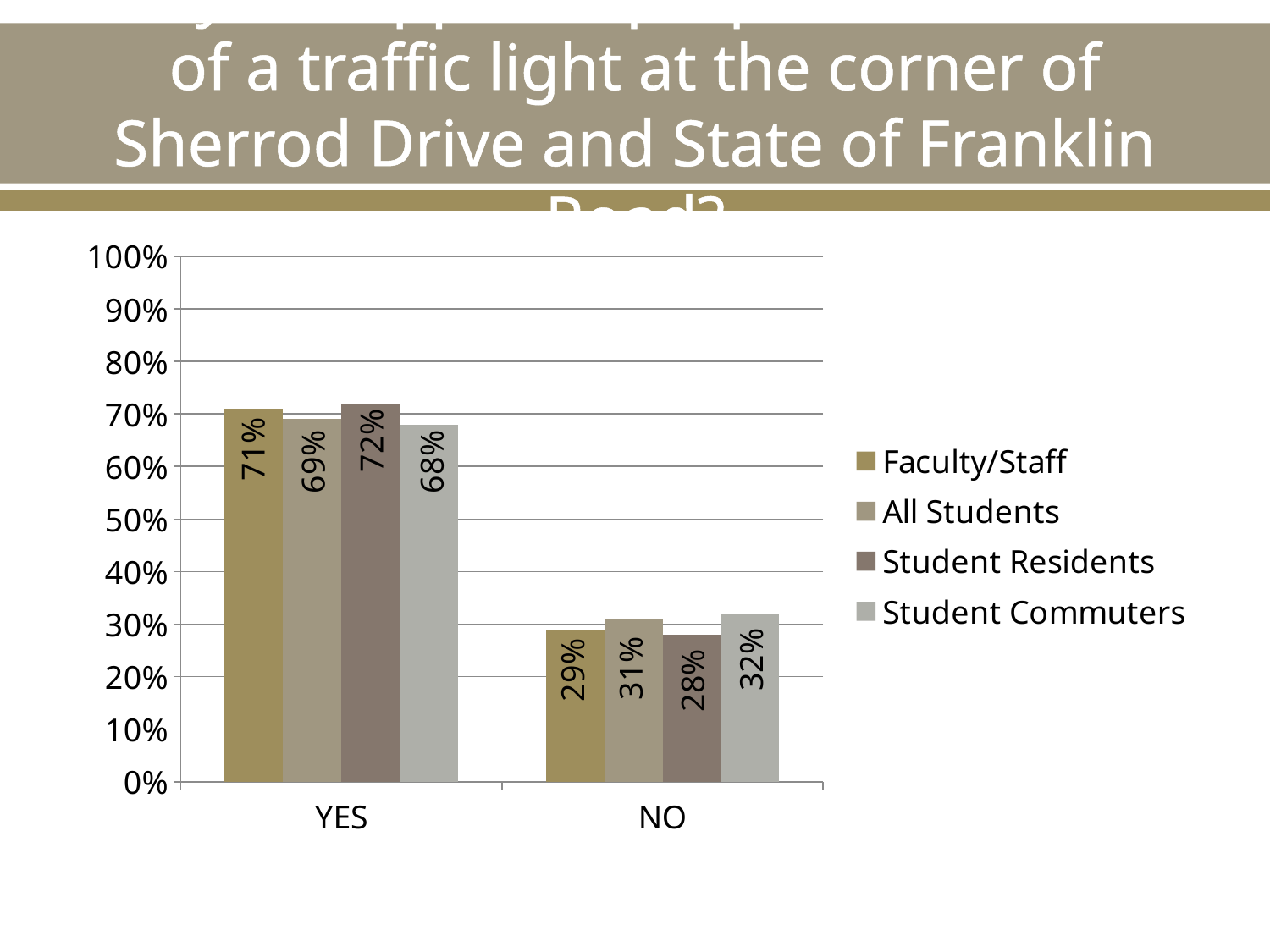
What is the value for Student Residents in the YES category? 72% Which group has the highest YES percentage? Student Residents What is the difference between the YES and NO percentages for Faculty/Staff? 42% What kind of chart is shown on the slide? Bar chart What percentage of Faculty/Staff answered YES? 71% How many categories are shown on the x axis? 2 Which is larger: the YES value for Student Commuters or the YES value for Student Residents? Student Residents What is the value for All Students in the NO category? 31% What is the total of the YES and NO values for All Students? 100% Which group has the lowest NO percentage? Student Residents What percentage of Student Commuters answered NO? 32% How many series does the legend list? 4